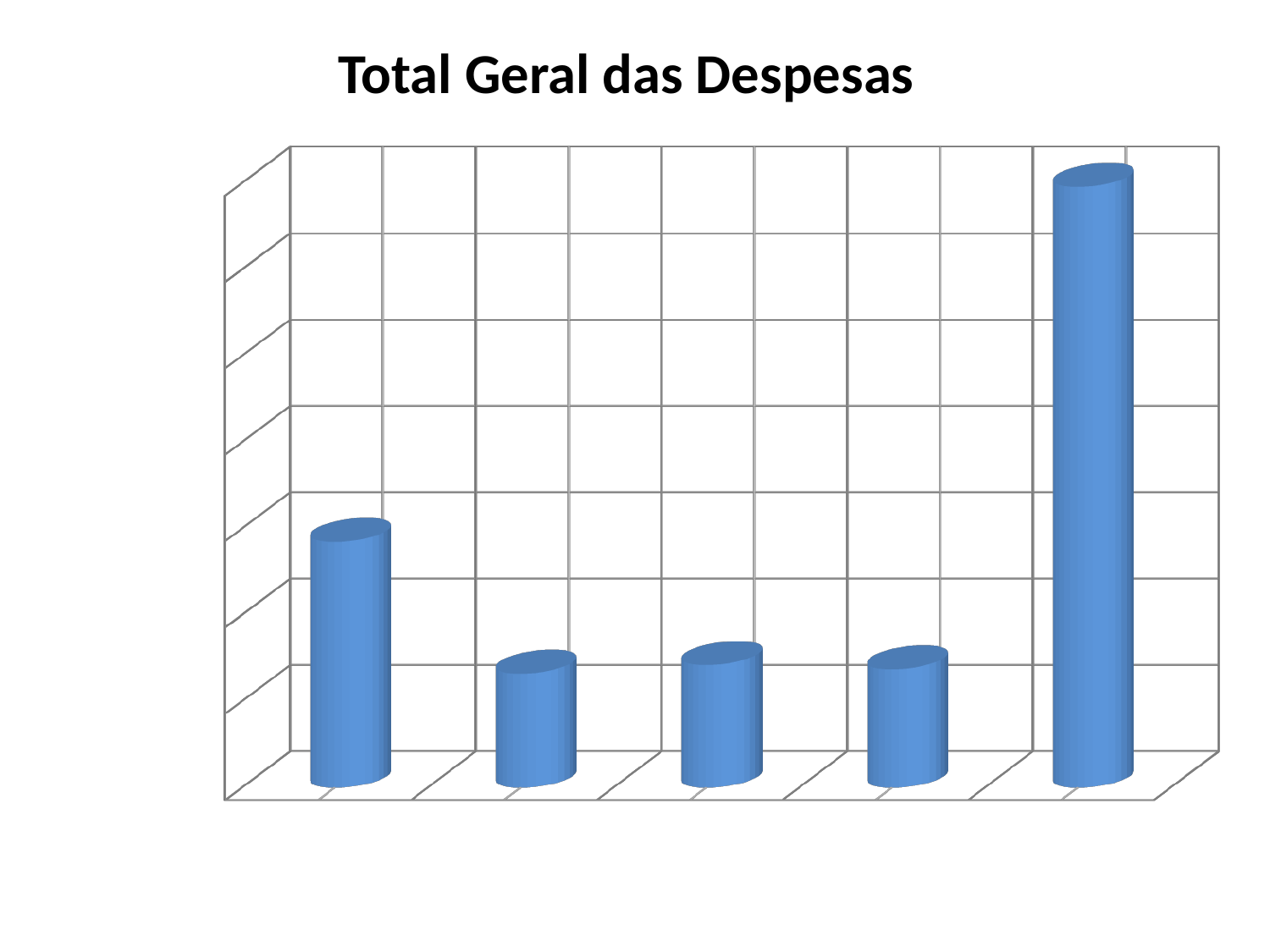
What is the title of the chart? Total Geral das Despesas Is the first (leftmost) bar taller or shorter than the second bar? taller What colour are the bars in the chart? blue What kind of chart is shown on the slide? bar chart Is the third bar from the left taller or shorter than the fifth bar? shorter How many bars are plotted in the chart? 5 Is the rightmost bar taller or shorter than the leftmost bar? taller Which bar is the highest in the chart, counting from the left? the fifth (rightmost) bar